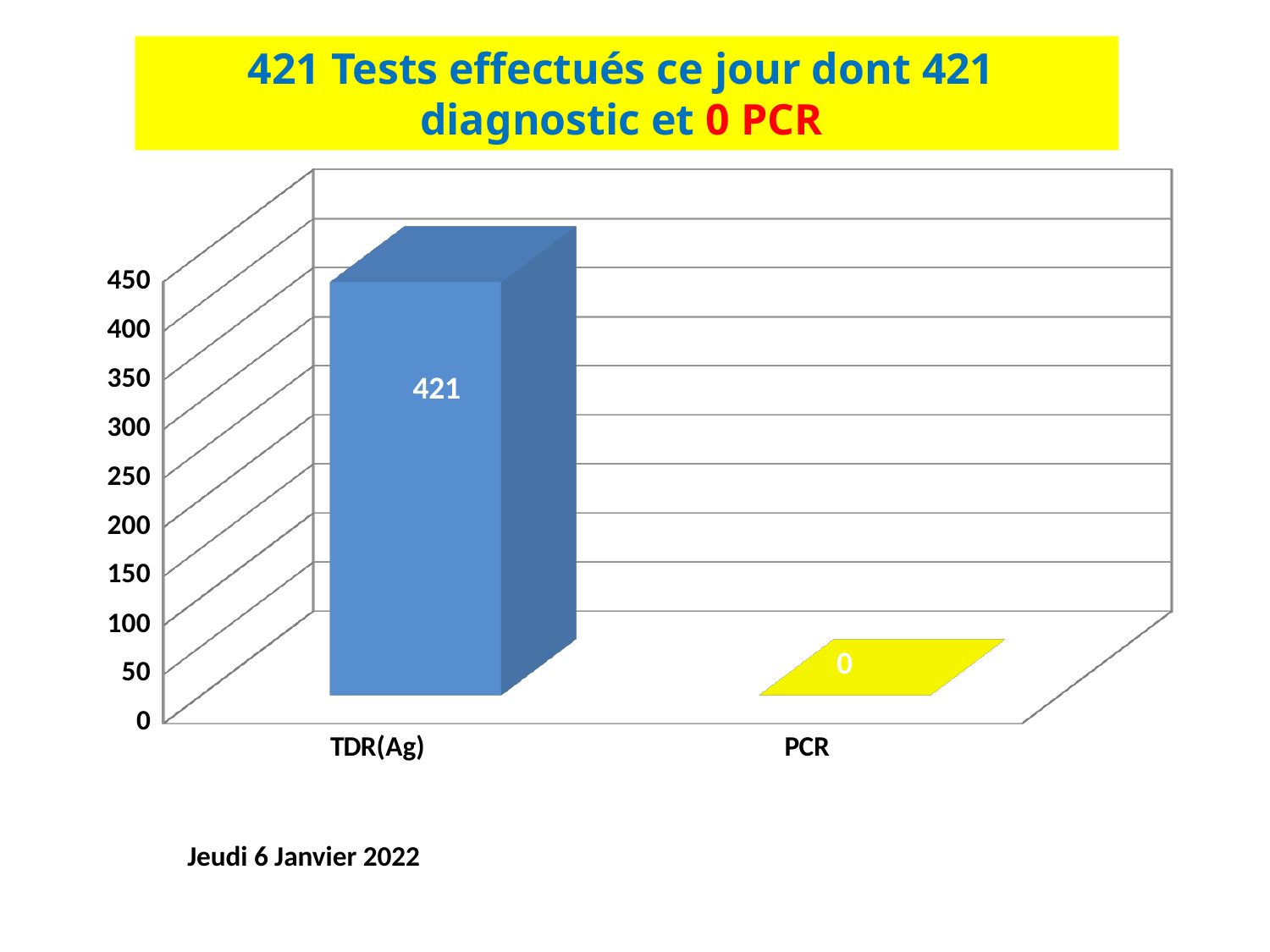
What is the difference between the values for TDR(Ag) and PCR? 421 What colour is the bar for TDR(Ag)? blue What is the value for TDR(Ag)? 421 What kind of chart is shown on the slide? bar chart What is the total of the values for TDR(Ag) and PCR? 421 Which category has the lowest value? PCR How many categories are shown on the x axis? 2 What is the title of the chart? 421 Tests effectués ce jour dont 421 diagnostic et 0 PCR Which category has the highest value? TDR(Ag) What is the value for PCR? 0 Which is larger, the value for TDR(Ag) or the value for PCR? TDR(Ag) Is the value for TDR(Ag) greater or less than 400? greater